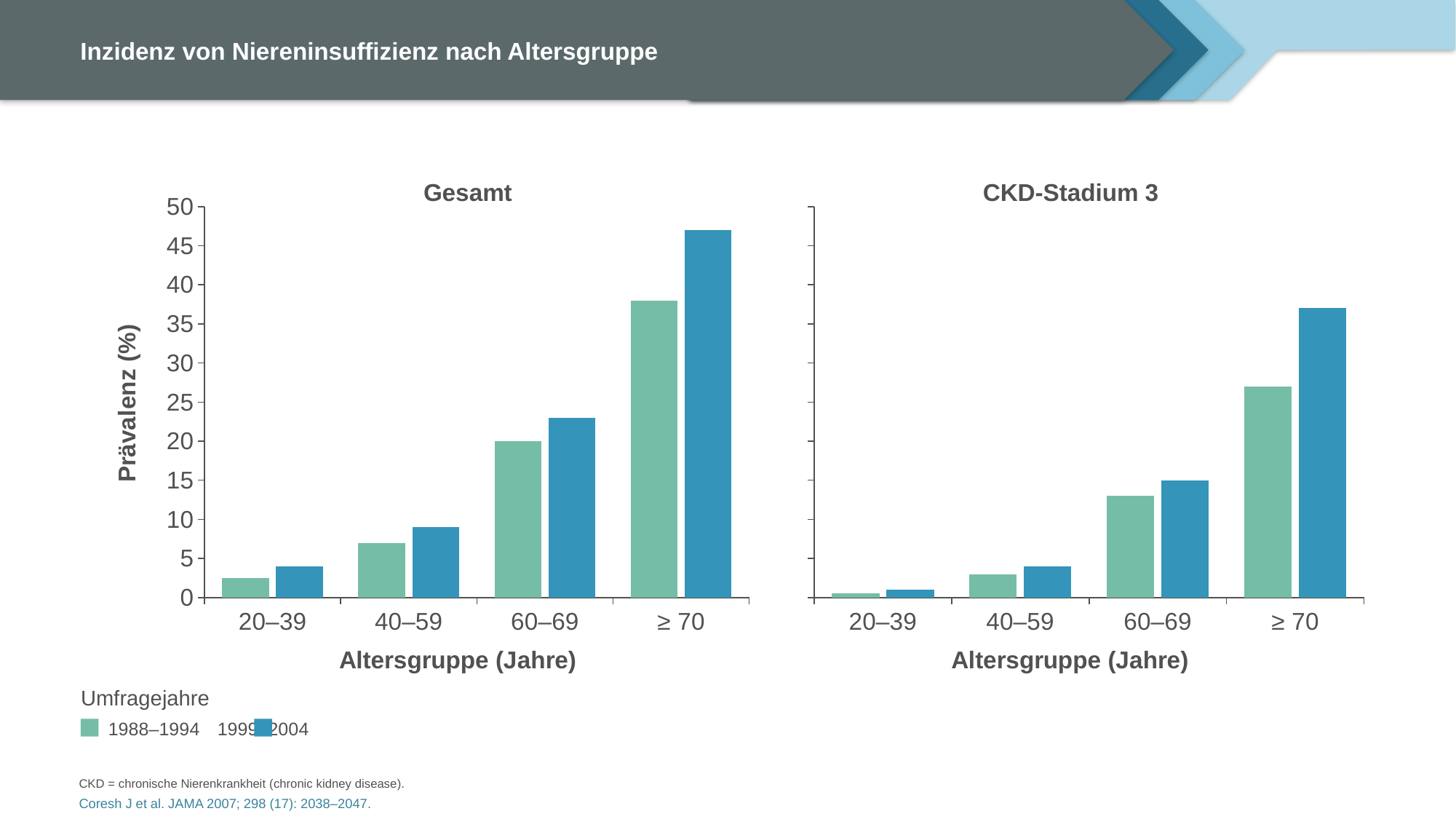
In the "CKD-Stadium 3" chart, which age group has the lowest prevalence for 1988–1994? 20–39 What kind of chart is the "Gesamt" chart? bar chart In the "CKD-Stadium 3" chart, is the 1988–1994 value for the ≥ 70 age group greater or less than 25? greater In the "Gesamt" chart, is the 1999–2004 value for the ≥ 70 age group greater or less than 45? greater What is the title of the right-hand chart? CKD-Stadium 3 In the "Gesamt" chart, which age group has the highest prevalence for 1999–2004? ≥ 70 In the "Gesamt" chart, is the 1988–1994 value for the 40–59 age group greater or less than 10? less In the "CKD-Stadium 3" chart, do the 1999–2004 values rise or fall as the age group increases along the x axis? rise How many age-group categories are shown on the x axis of the "CKD-Stadium 3" chart? 4 What is the y-axis label on the "Gesamt" chart? Prävalenz (%) In the "Gesamt" chart, which is larger for the 60–69 age group: the 1988–1994 value or the 1999–2004 value? 1999–2004 How many series does the legend list for the charts? 2